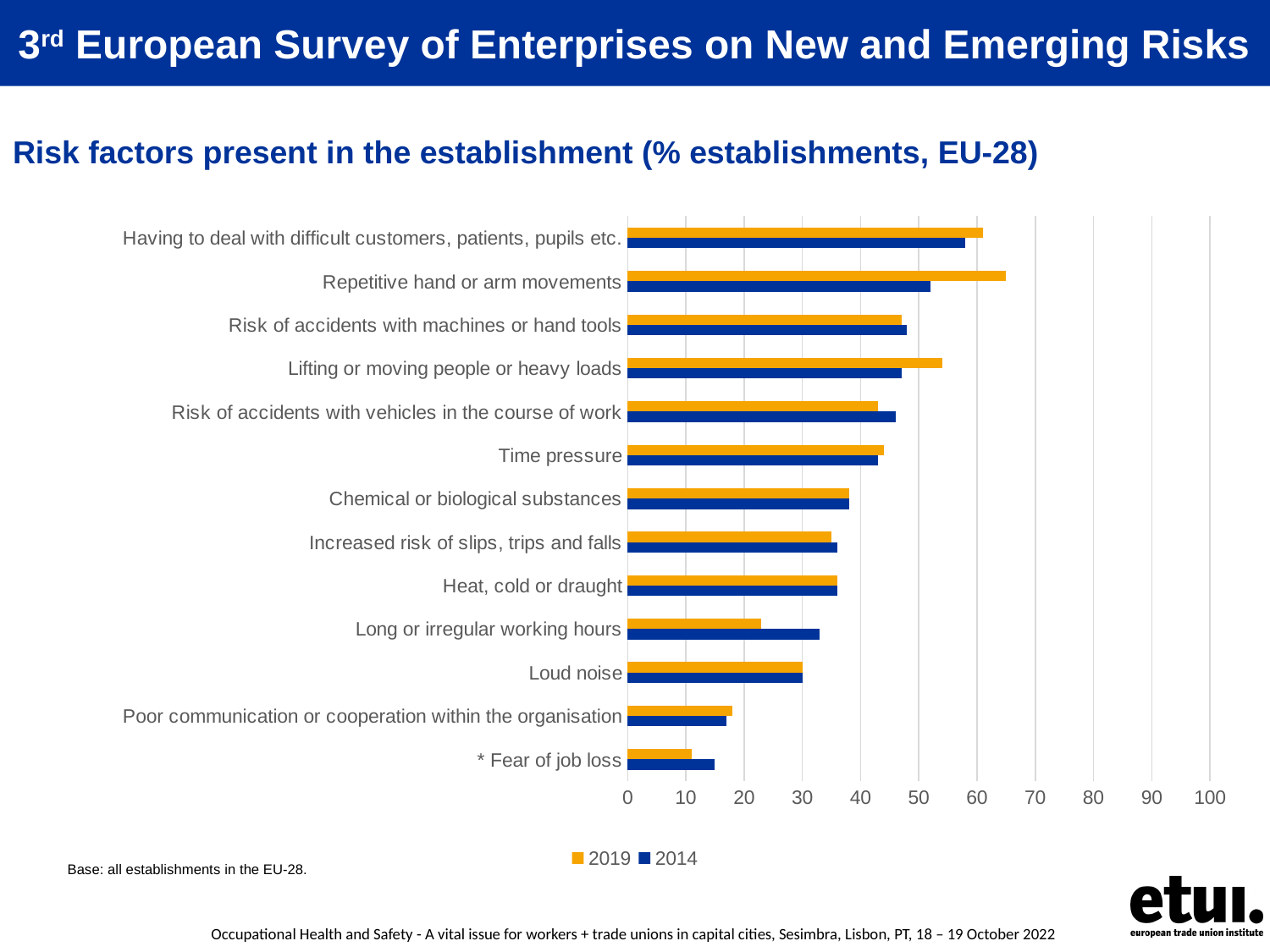
Which risk factor has the highest value for 2014? Having to deal with difficult customers, patients, pupils etc. For Long or irregular working hours, which year has the larger value, 2019 or 2014? 2014 How many risk factor categories are plotted on the chart? 13 Which risk factor has the lowest value for 2019? * Fear of job loss Which years are shown in the chart legend? 2019 and 2014 Is the 2014 value for * Fear of job loss greater or less than 20? less How many series does the legend list? 2 Is the 2019 value for Long or irregular working hours greater or less than 30? less For Lifting or moving people or heavy loads, which year has the larger value, 2019 or 2014? 2019 Which risk factor has the highest value for 2019? Repetitive hand or arm movements Is the 2019 value for Repetitive hand or arm movements greater or less than 60? greater What kind of chart is shown on the slide? Bar chart